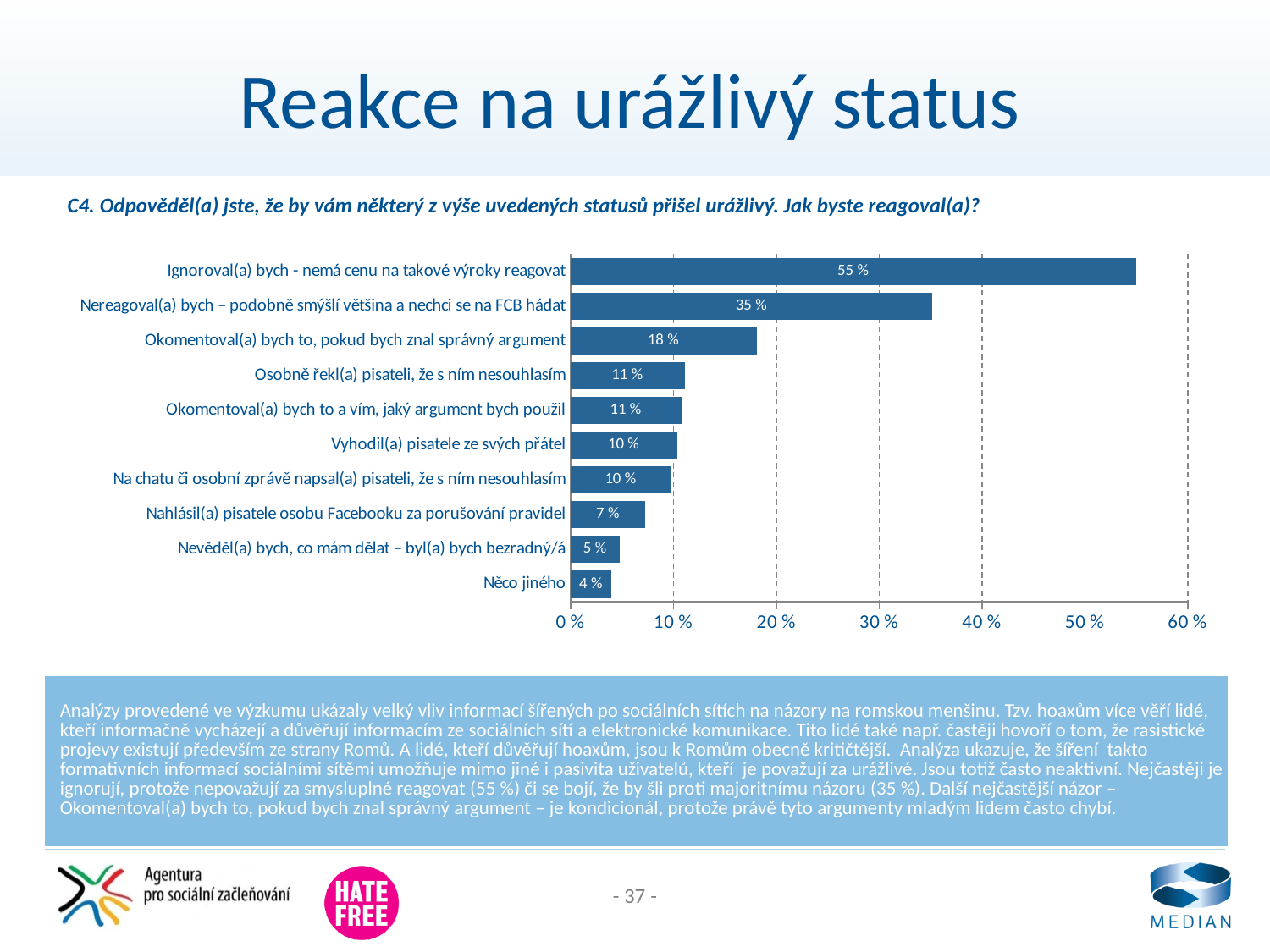
Is the value for "Nereagoval(a) bych – podobně smýšlí většina a nechci se na FCB hádat" greater or less than 30 %? greater What is the value for "Osobně řekl(a) pisateli, že s ním nesouhlasím"? 11 % What is the value for "Ignoroval(a) bych - nemá cenu na takové výroky reagovat"? 55 % What kind of chart is shown on the slide? bar chart Which category has the highest value? Ignoroval(a) bych - nemá cenu na takové výroky reagovat What is the title of the slide containing the chart? Reakce na urážlivý status How many categories are shown in the chart? 10 Which category has the lowest value? Něco jiného Which is larger: the value for "Vyhodil(a) pisatele ze svých přátel" or the value for "Nevěděl(a) bych, co mám dělat – byl(a) bych bezradný/á"? Vyhodil(a) pisatele ze svých přátel What is the value for "Nahlásil(a) pisatele osobu Facebooku za porušování pravidel"? 7 % What is the difference between the values for "Ignoroval(a) bych - nemá cenu na takové výroky reagovat" and "Nereagoval(a) bych – podobně smýšlí většina a nechci se na FCB hádat"? 20 % What is the value for "Okomentoval(a) bych to, pokud bych znal správný argument"? 18 %